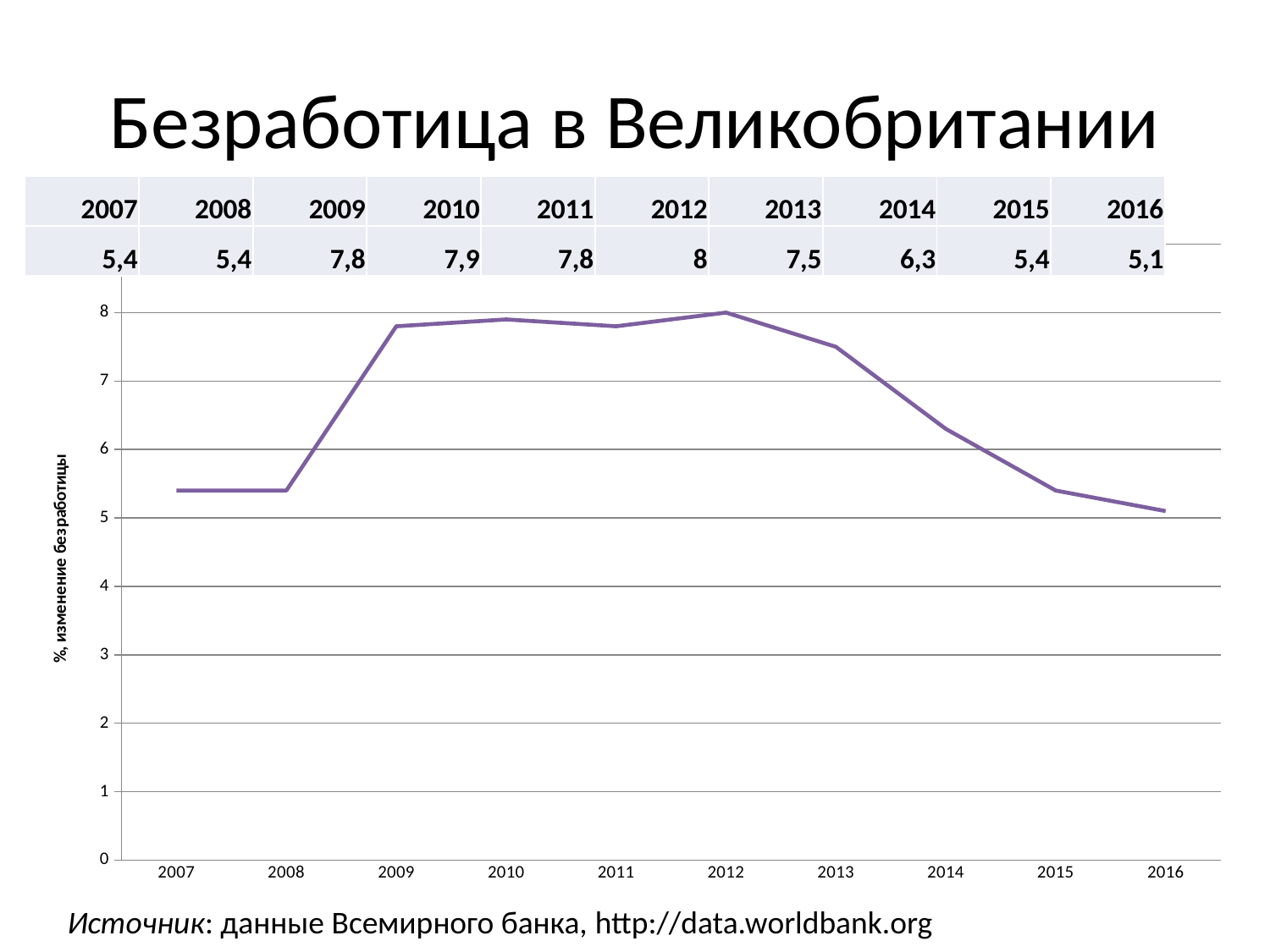
Which year had a higher unemployment rate, 2009 or 2014? 2009 In which year was the unemployment rate lowest? 2016 In which year was the unemployment rate highest? 2012 By how much did the unemployment rate fall from 2012 to 2016? 2,9 What was the unemployment rate in the UK in 2014? 6,3 Is the value for 2014 greater or less than 6? greater What was the unemployment rate in the UK in 2016? 5,1 What type of chart is shown on the slide? Line chart What was the unemployment rate in the UK in 2012? 8 What is the difference between the unemployment rate in 2014 and in 2015? 0,9 How many years are plotted on the chart? 10 Does the unemployment rate rise or fall from 2012 to 2016? Fall